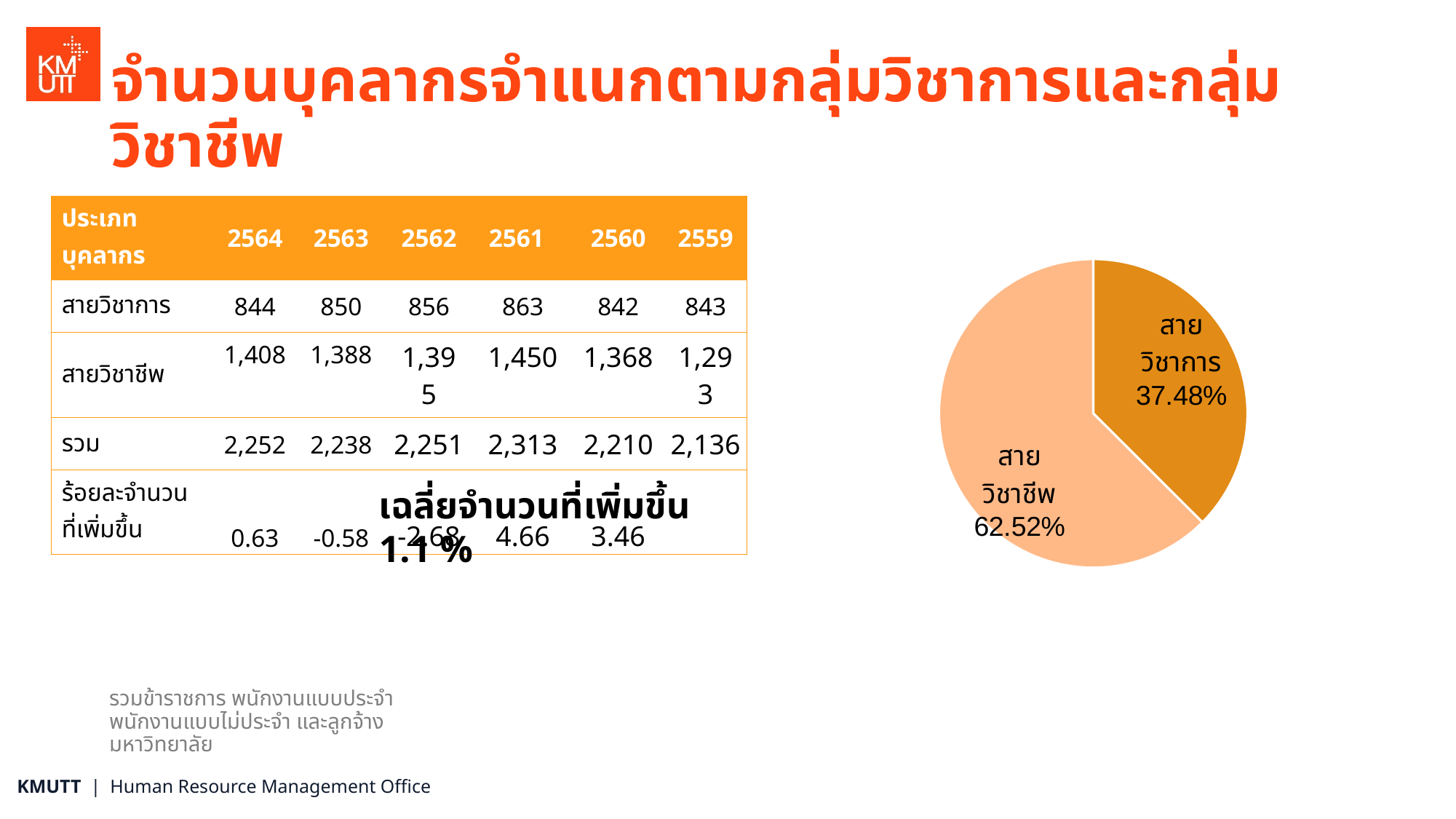
What share of the pie chart does สายวิชาการ represent? 37.48% What kind of chart is shown on the right side of the slide? pie chart Which slice of the pie chart is the largest? สายวิชาชีพ Which slice of the pie chart is drawn in the darker orange colour? สายวิชาการ Does the pie chart have a separate legend, or are the labels placed on the slices? labels on the slices In the pie chart, which is larger: สายวิชาการ or สายวิชาชีพ? สายวิชาชีพ Is the share for สายวิชาชีพ in the pie chart greater or less than 50%? greater By how many percentage points does the สายวิชาชีพ slice exceed the สายวิชาการ slice in the pie chart? 25.04 What share of the pie chart does สายวิชาชีพ represent? 62.52% Which slice of the pie chart is the smallest? สายวิชาการ Is the share for สายวิชาการ in the pie chart greater or less than 50%? less How many slices does the pie chart have? 2